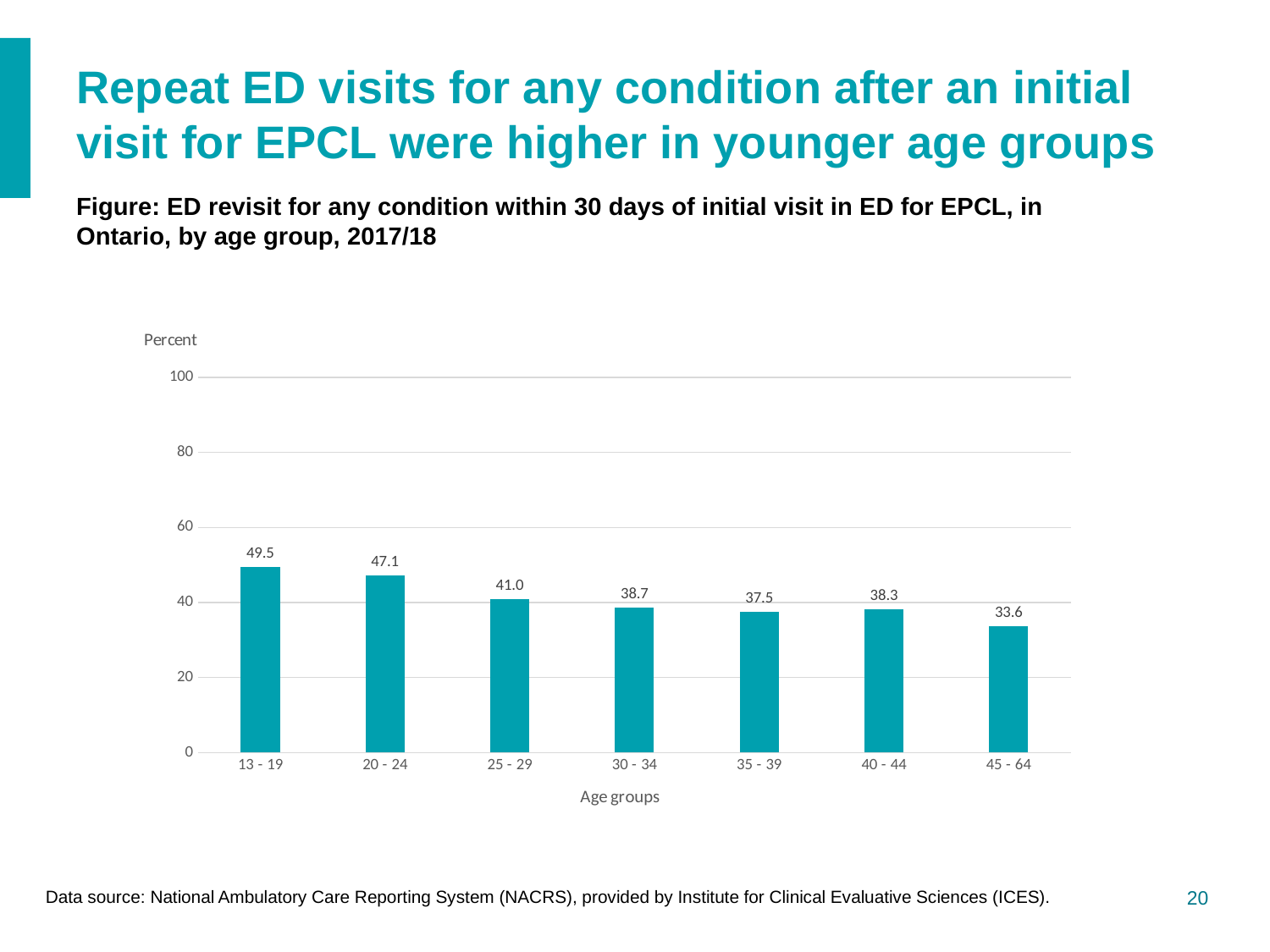
What kind of chart is shown on the slide? Bar chart What is the percent value for the 45 - 64 age group? 33.6 What is the percent value for the 13 - 19 age group? 49.5 What is the percent value for the 30 - 34 age group? 38.7 What is the difference in percent between the 20 - 24 and 25 - 29 age groups? 6.1 What is the difference in percent between the 13 - 19 and 45 - 64 age groups? 15.9 Which age group has a higher percent value, 25 - 29 or 35 - 39? 25 - 29 Is the value for the 20 - 24 age group greater or less than 40? greater Which age group has the highest percent of ED revisits? 13 - 19 What is the label of the x axis? Age groups Which age group has the lowest percent of ED revisits? 45 - 64 How many age groups are shown on the chart? 7